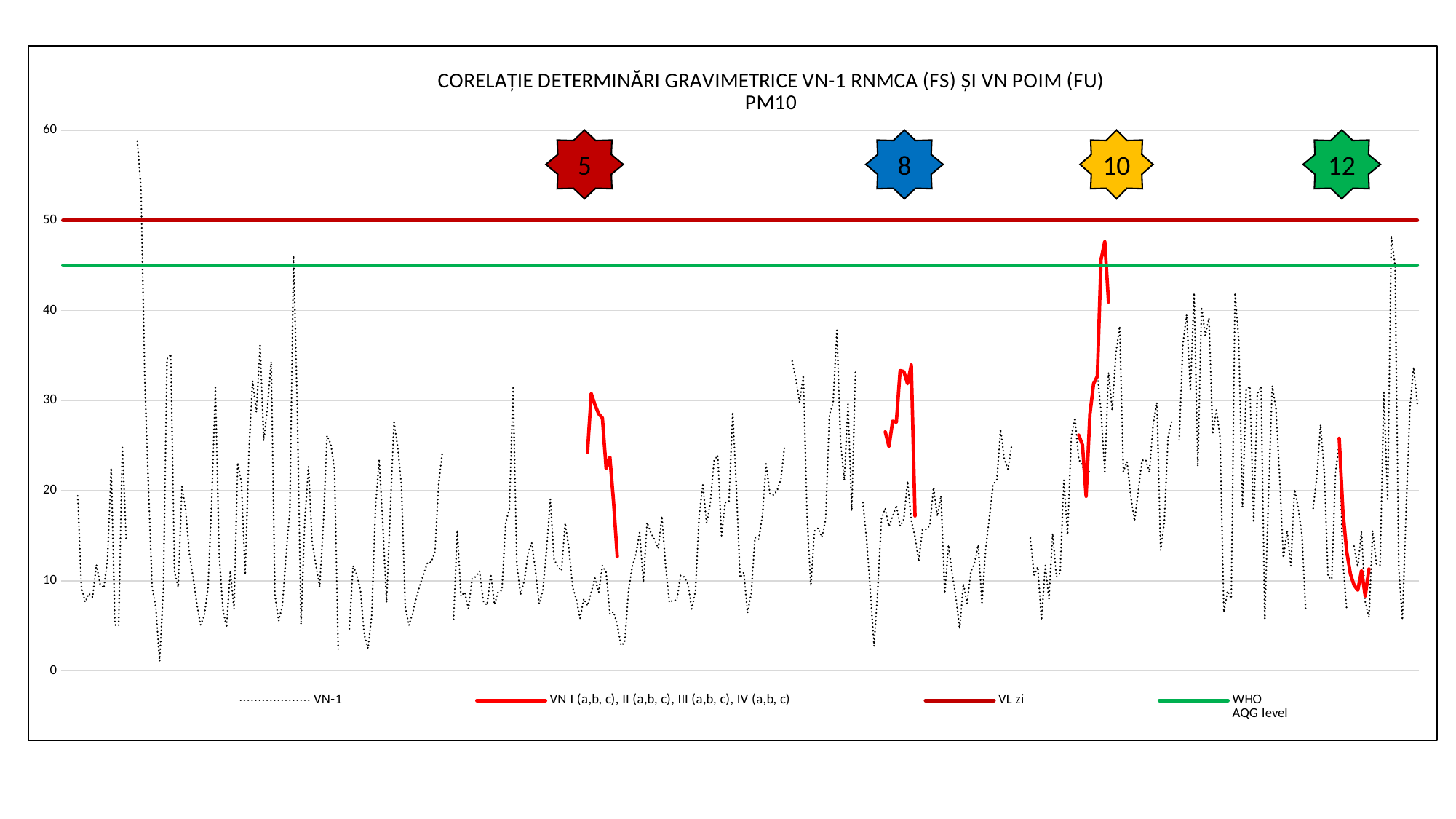
How many series does the legend list? 4 Is the highest value of the red VN I–IV series greater or less than 50? less Is the highest peak of the VN-1 series greater or less than 50? greater What kind of chart is shown on the slide? line chart Is the WHO AQG level line greater or less than 40? greater What is the maximum value shown on the vertical axis? 60 Which is higher, the VL zi line or the WHO AQG level line? VL zi What colour is the WHO AQG level line? green What is the value of the VL zi line? 50